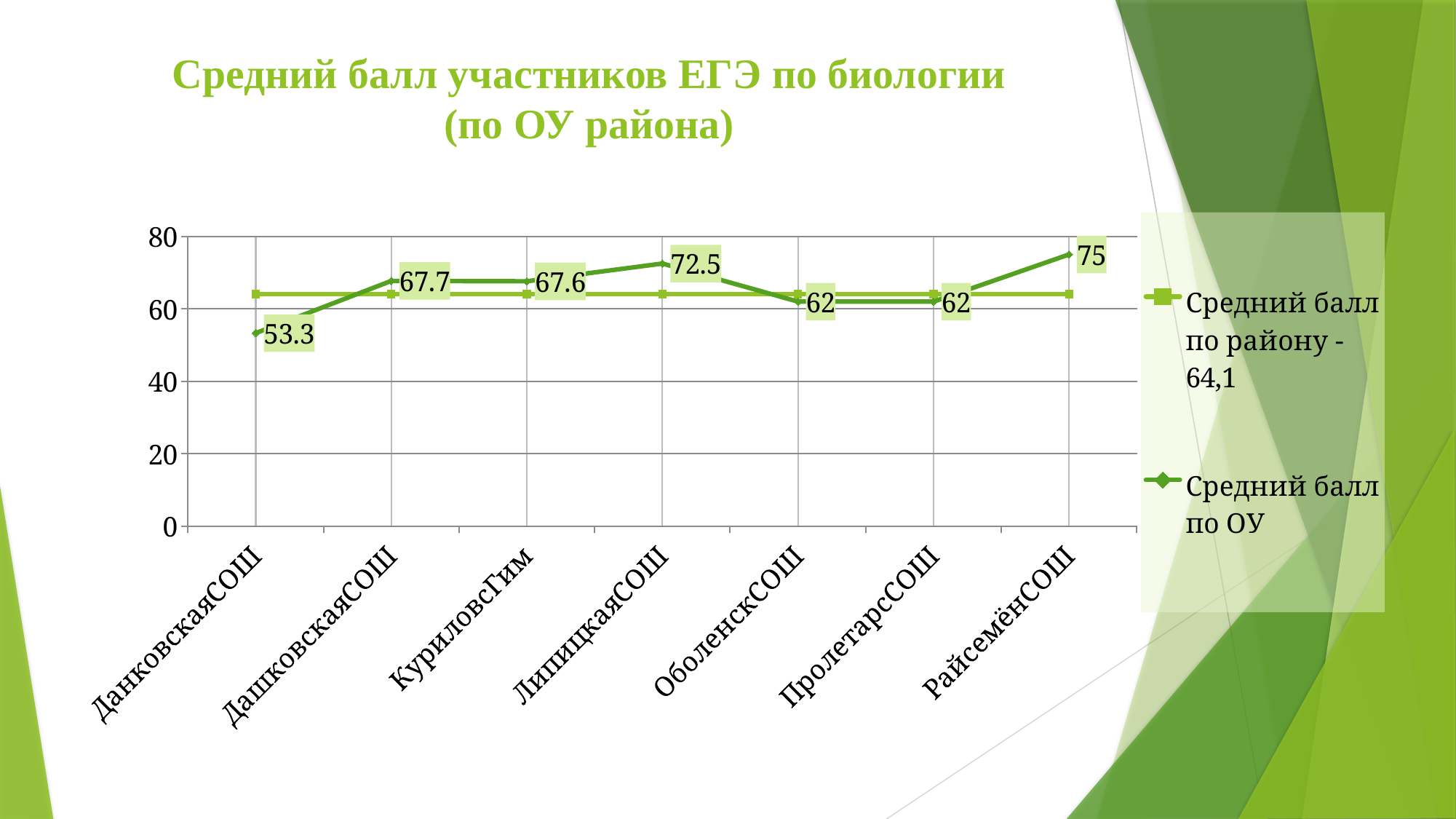
How many series does the legend list? 2 What is the average score (Средний балл по ОУ) for ДанковскаяСОШ? 53.3 Is the value for ДанковскаяСОШ greater or less than 60? less Which school has the lowest average score in the Средний балл по ОУ series? ДанковскаяСОШ What kind of chart is shown on the slide? line chart What district average value is given in the legend entry 'Средний балл по району'? 64,1 How many schools are shown on the x axis? 7 What is the average score (Средний балл по ОУ) for ЛипицкаяСОШ? 72.5 What is the difference between the average scores of РайсемёнСОШ and ДанковскаяСОШ? 21.7 Which school has the highest average score in the Средний балл по ОУ series? РайсемёнСОШ Which has a higher average score, ЛипицкаяСОШ or ОболенскСОШ? ЛипицкаяСОШ What is the average score (Средний балл по ОУ) for РайсемёнСОШ? 75